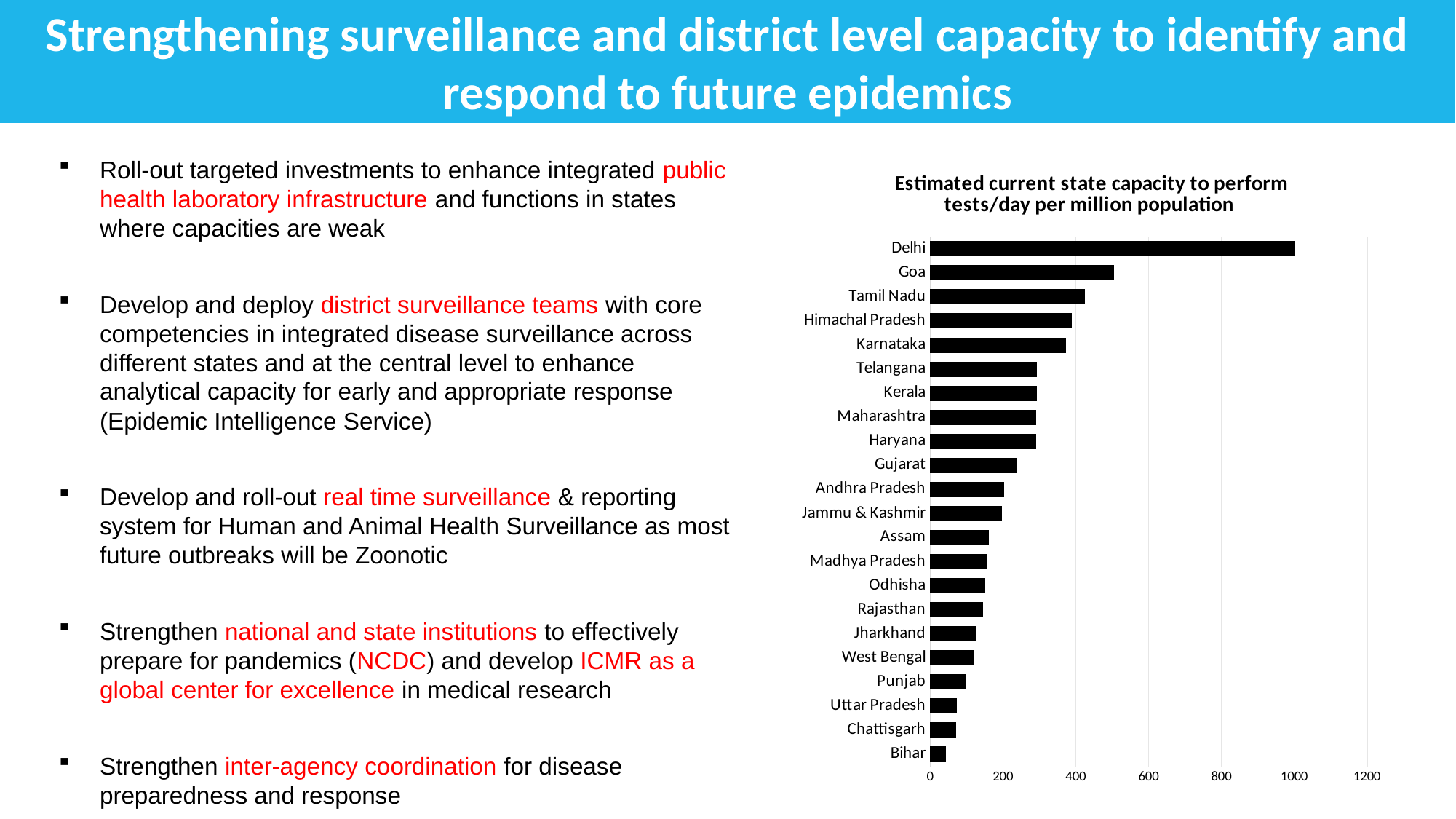
Is the value for Bihar greater or less than 100? less Which state has the lowest estimated capacity to perform tests/day per million population? Bihar What kind of chart is shown on the slide? bar chart Which state has the highest estimated capacity to perform tests/day per million population? Delhi Which has a higher value, Goa or Tamil Nadu? Goa Which has a higher value, Gujarat or Assam? Gujarat Is the value for Goa greater or less than 400? greater Is the value for Punjab greater or less than 200? less What is the title of the chart? Estimated current state capacity to perform tests/day per million population How many states are shown in the chart? 22